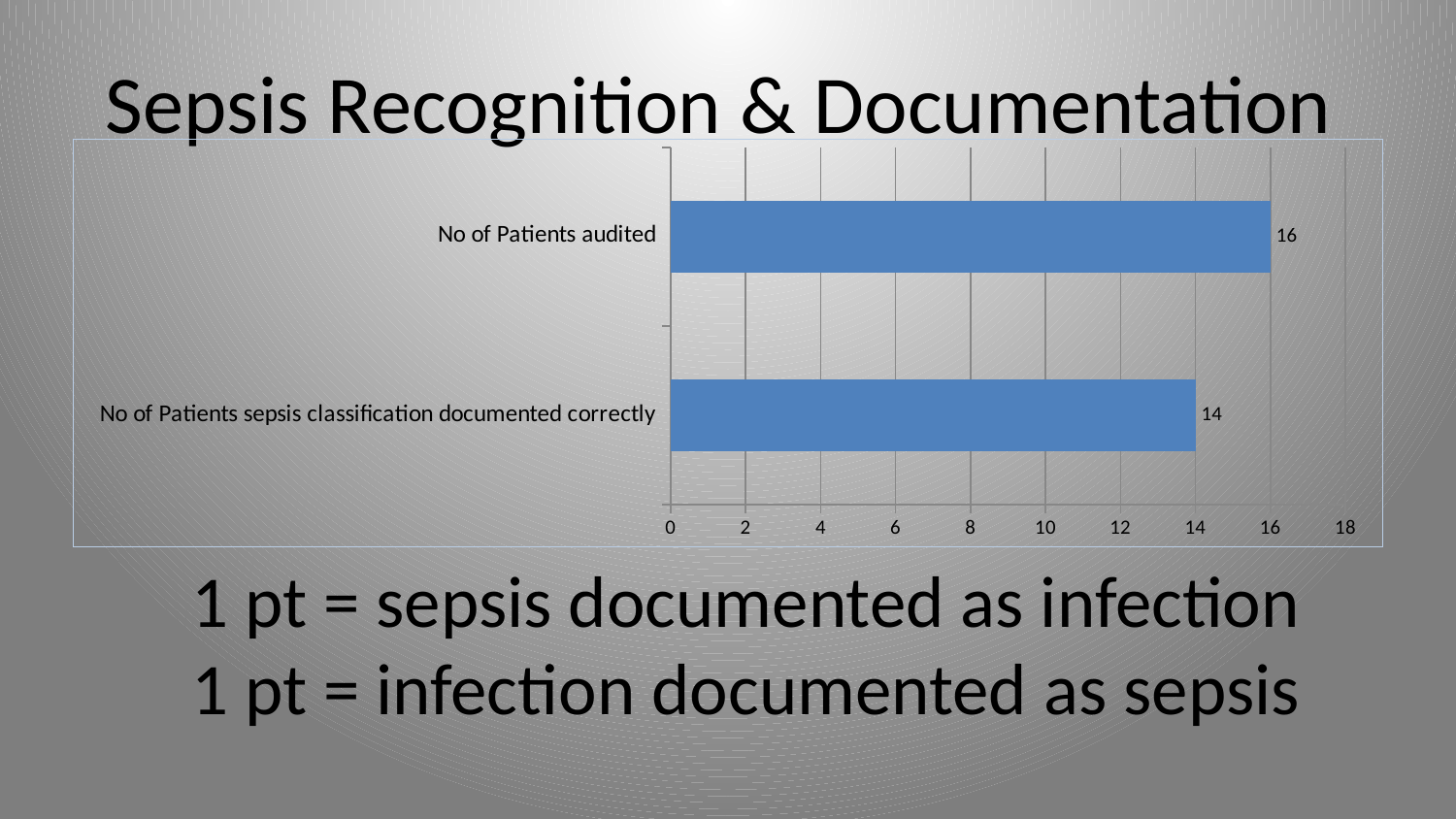
What is the difference between the number of patients audited and the number with sepsis classification documented correctly? 2 Is the value for 'No of Patients audited' greater or less than 10? greater What is the value for 'No of Patients audited'? 16 What is the maximum value shown on the horizontal axis? 18 Which category has the highest value? No of Patients audited What kind of chart is shown on the slide? Bar chart Which is larger: the number of patients audited or the number with sepsis classification documented correctly? No of Patients audited Which category has the lowest value? No of Patients sepsis classification documented correctly What is the title of the slide containing the chart? Sepsis Recognition & Documentation What is the value for 'No of Patients sepsis classification documented correctly'? 14 Is the value for 'No of Patients sepsis classification documented correctly' greater or less than 18? less How many categories are shown in the chart? 2